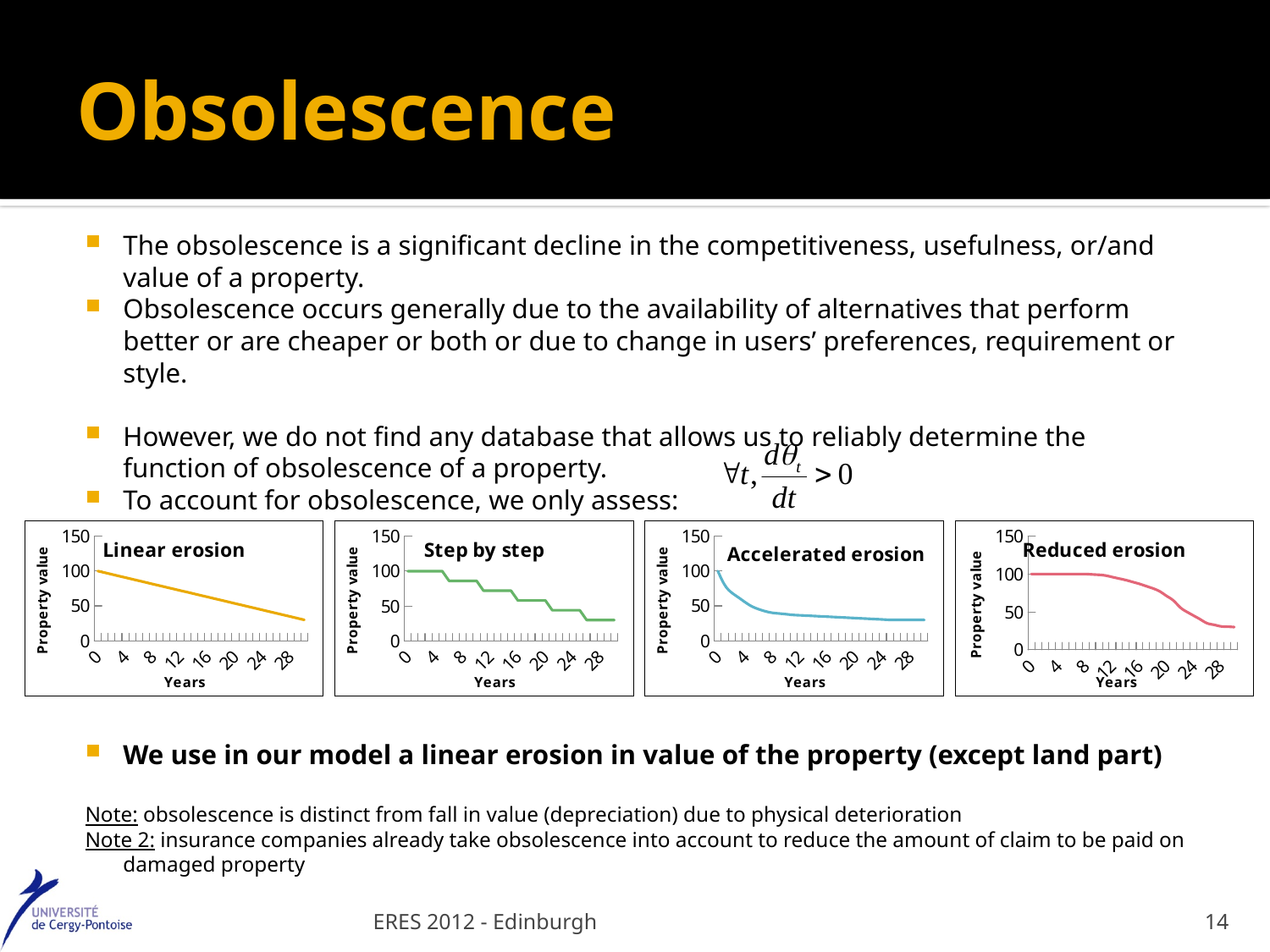
In the 'Accelerated erosion' chart, does the property value rise or fall along the x axis? fall At year 12, which chart shows the higher property value: 'Reduced erosion' or 'Accelerated erosion'? Reduced erosion In the 'Step by step' chart, what is the property value at year 0? 100 In the 'Reduced erosion' chart, is the property value at year 8 greater or less than 50? greater What is the y-axis title of the 'Reduced erosion' chart? Property value In the 'Linear erosion' chart, does the property value rise or fall as the years increase? fall How many charts are shown on the slide? 4 What is the x-axis title of the 'Step by step' chart? Years In the 'Linear erosion' chart, what is the property value at year 0? 100 What kind of chart is the 'Linear erosion' chart? line chart In the 'Accelerated erosion' chart, is the property value at year 24 greater or less than 50? less In the 'Linear erosion' chart, is the property value at year 28 greater or less than 50? less